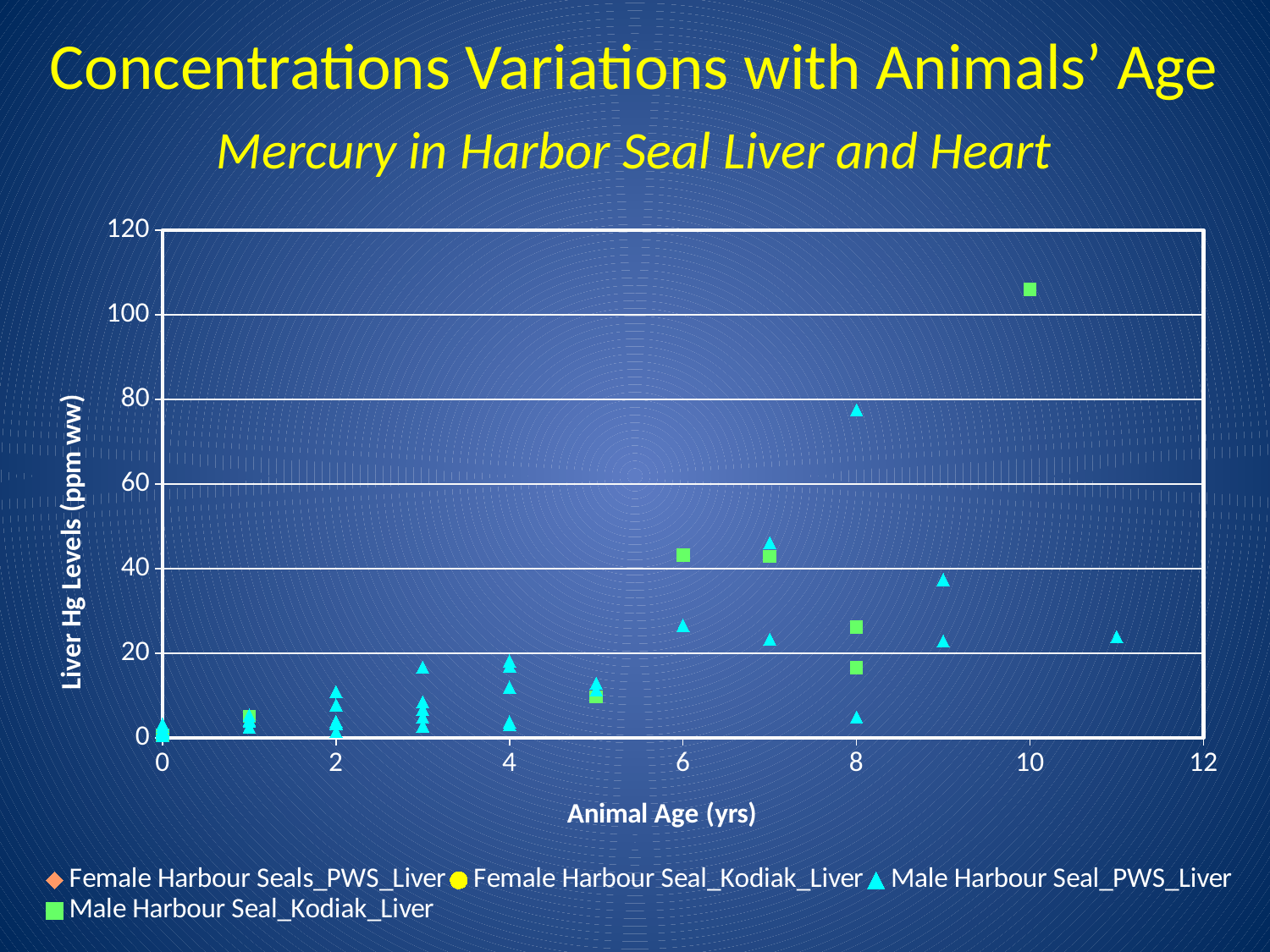
What is the label of the x axis? Animal Age (yrs) Which is higher: the Male Harbour Seal_Kodiak_Liver point at age 10 or the highest Male Harbour Seal_PWS_Liver point at age 8? Male Harbour Seal_Kodiak_Liver point at age 10 Is the Male Harbour Seal_Kodiak_Liver point at age 6 greater or less than 40? greater Is the highest Male Harbour Seal_PWS_Liver point (at age 8) greater or less than 80? less Is the highest Male Harbour Seal_PWS_Liver point (at age 8) greater or less than 60? greater What is the label of the y axis? Liver Hg Levels (ppm ww) Which series contains the highest plotted point on the chart? Male Harbour Seal_Kodiak_Liver What kind of chart is shown on the slide? scatter chart How many series does the legend list? 4